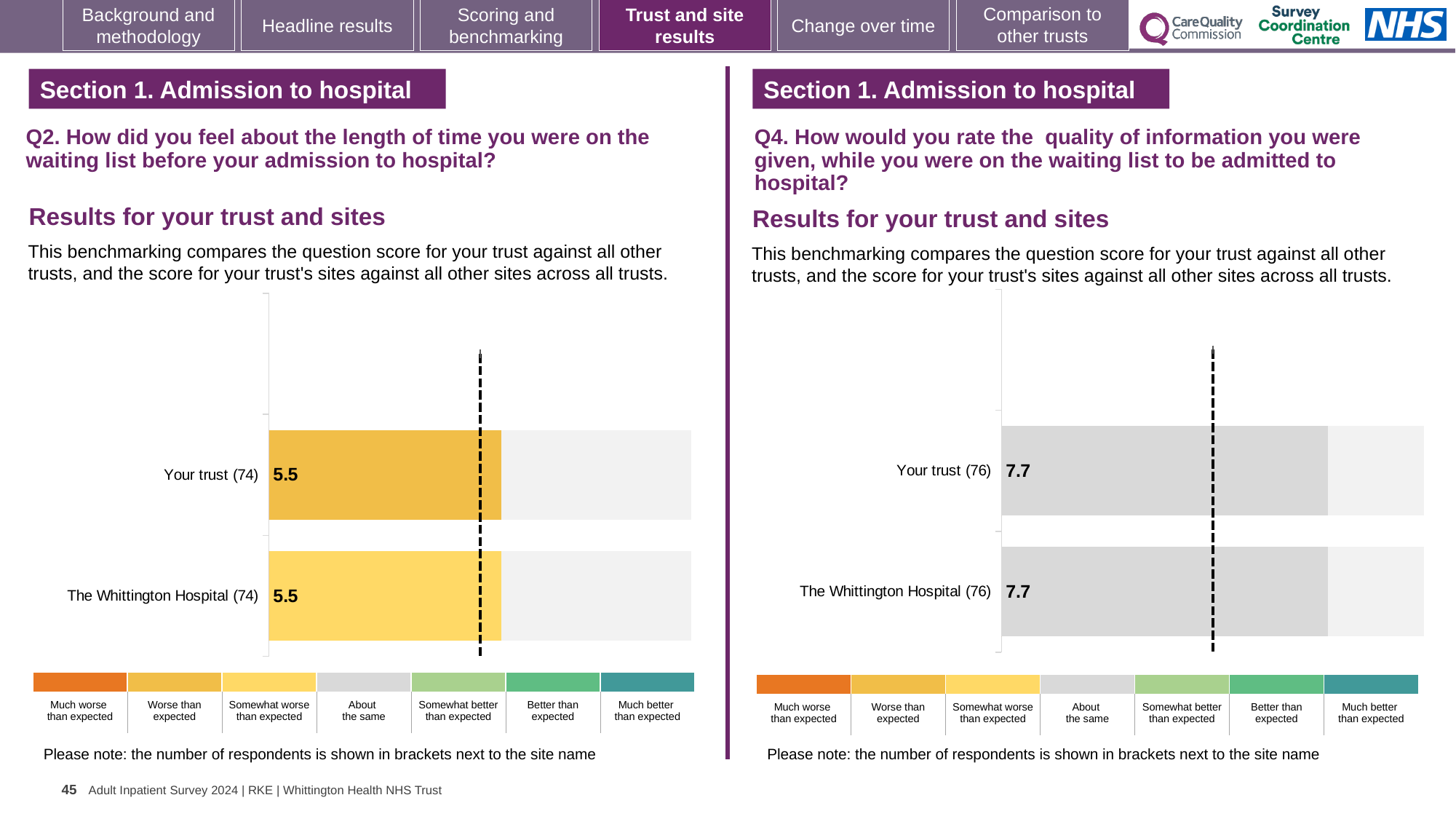
On the left chart (Q2), what is the difference between the score for Your trust and the score for The Whittington Hospital? 0 On the right chart (Q4), what is the score for The Whittington Hospital? 7.7 How many bars are plotted on the right chart (Q4)? 2 On the right chart (Q4), what is the score for Your trust? 7.7 Is the score for Your trust on the right chart (Q4) larger or smaller than the score for Your trust on the left chart (Q2)? Larger On the right chart (Q4), how many respondents are shown in brackets next to The Whittington Hospital? 76 On the left chart (Q2), what is the score for Your trust? 5.5 What kind of chart is used on the left (Q2)? Bar chart How many bars are plotted on the left chart (Q2)? 2 On the right chart (Q4), what is the difference between the score for Your trust and the score for The Whittington Hospital? 0 On the left chart (Q2), how many respondents are shown in brackets next to Your trust? 74 On the left chart (Q2), what is the score for The Whittington Hospital? 5.5